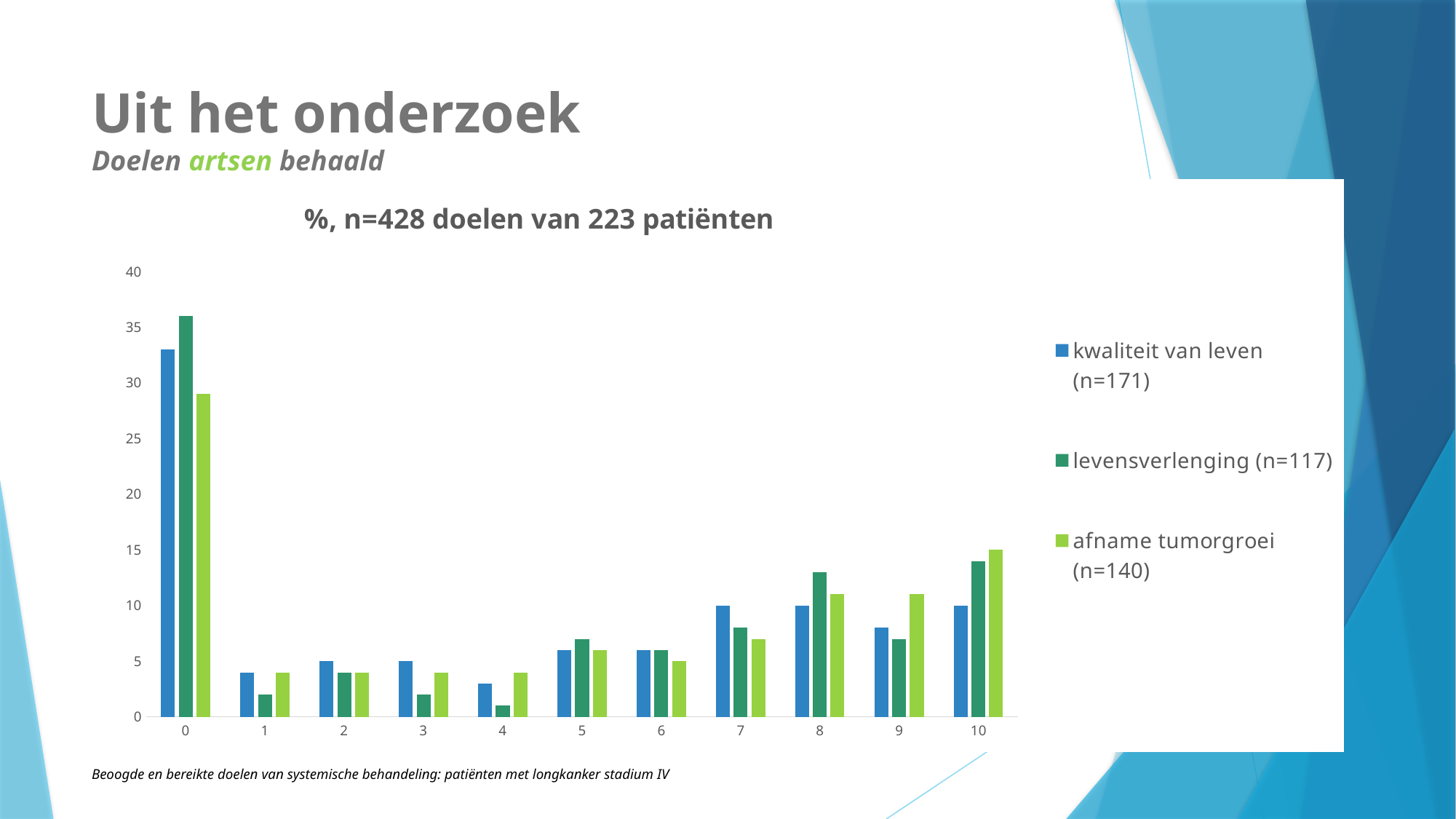
Which category has the lowest value for levensverlenging (n=117)? 4 At category 0, which series has the larger value: kwaliteit van leven (n=171) or levensverlenging (n=117)? levensverlenging (n=117) Which category has the highest value for levensverlenging (n=117)? 0 What kind of chart is shown on the slide? bar chart Is the value for levensverlenging (n=117) at category 1 greater or less than 5? less What is the title of the chart? %, n=428 doelen van 223 patiënten At category 9, which series has the larger value: levensverlenging (n=117) or afname tumorgroei (n=140)? afname tumorgroei (n=140) Is the value for afname tumorgroei (n=140) at category 0 greater or less than 25? greater How many categories are shown along the x axis? 11 Is the value for kwaliteit van leven (n=171) at category 0 greater or less than 30? greater How many series does the legend list? 3